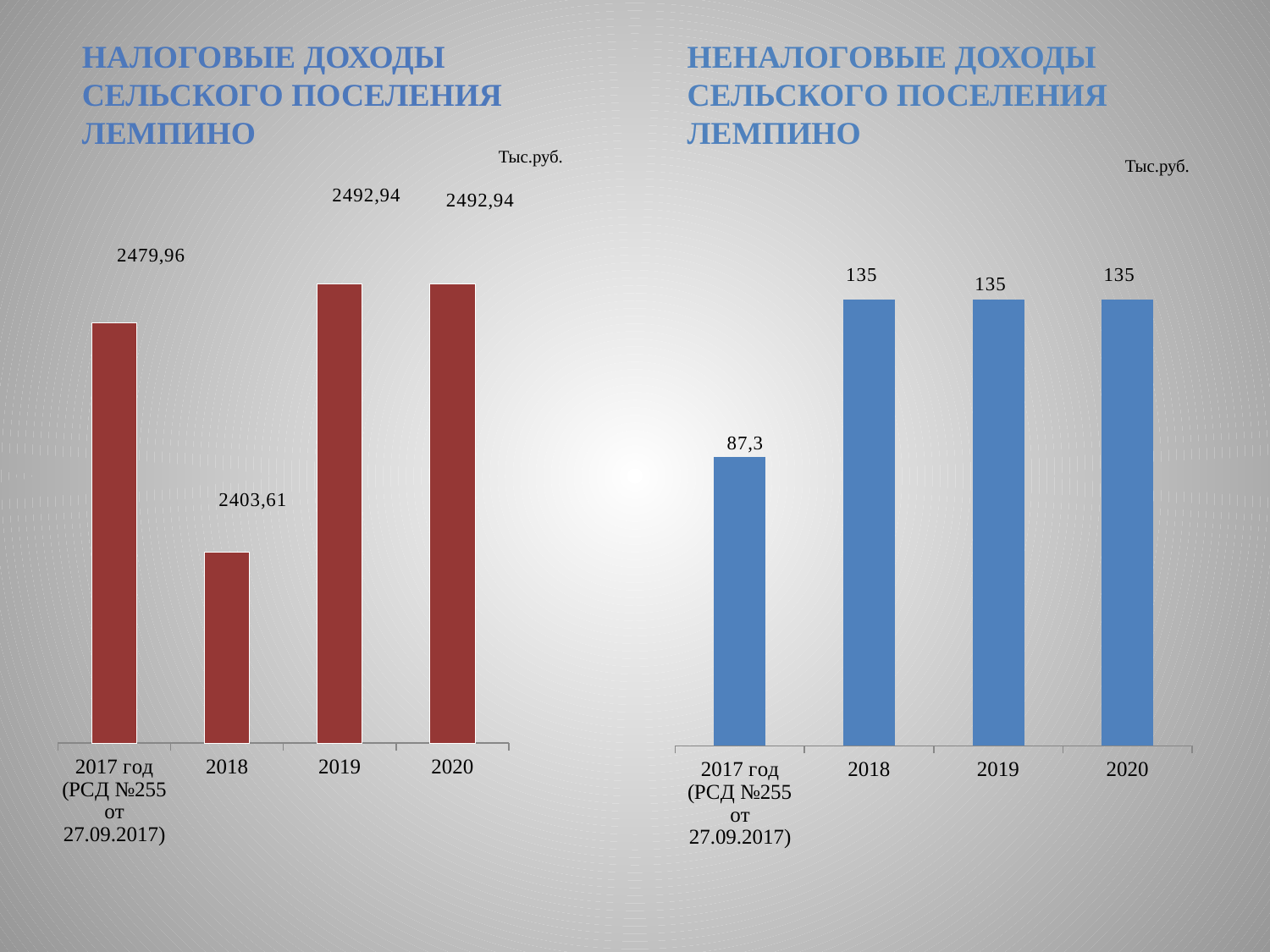
In the right chart (НЕНАЛОГОВЫЕ ДОХОДЫ), which is larger, the value for 2017 or the value for 2020? 2020 In the left chart (НАЛОГОВЫЕ ДОХОДЫ), what is the value for 2017 год (РСД №255 от 27.09.2017)? 2479,96 In the left chart (НАЛОГОВЫЕ ДОХОДЫ), what is the value for 2018? 2403,61 In the left chart (НАЛОГОВЫЕ ДОХОДЫ), what is the value for 2020? 2492,94 In the left chart (НАЛОГОВЫЕ ДОХОДЫ), what is the difference between the values for 2019 and 2018? 89,33 In the right chart (НЕНАЛОГОВЫЕ ДОХОДЫ), which year has the lowest value? 2017 год (РСД №255 от 27.09.2017) In the right chart (НЕНАЛОГОВЫЕ ДОХОДЫ), what is the value for 2017 год (РСД №255 от 27.09.2017)? 87,3 What type of chart is the right chart (НЕНАЛОГОВЫЕ ДОХОДЫ)? Bar chart In the left chart (НАЛОГОВЫЕ ДОХОДЫ), which year has the lowest value? 2018 In the left chart (НАЛОГОВЫЕ ДОХОДЫ), how many bars are plotted? 4 In the right chart (НЕНАЛОГОВЫЕ ДОХОДЫ), what is the value for 2019? 135 In the right chart (НЕНАЛОГОВЫЕ ДОХОДЫ), what is the difference between the values for 2018 and 2017? 47,7